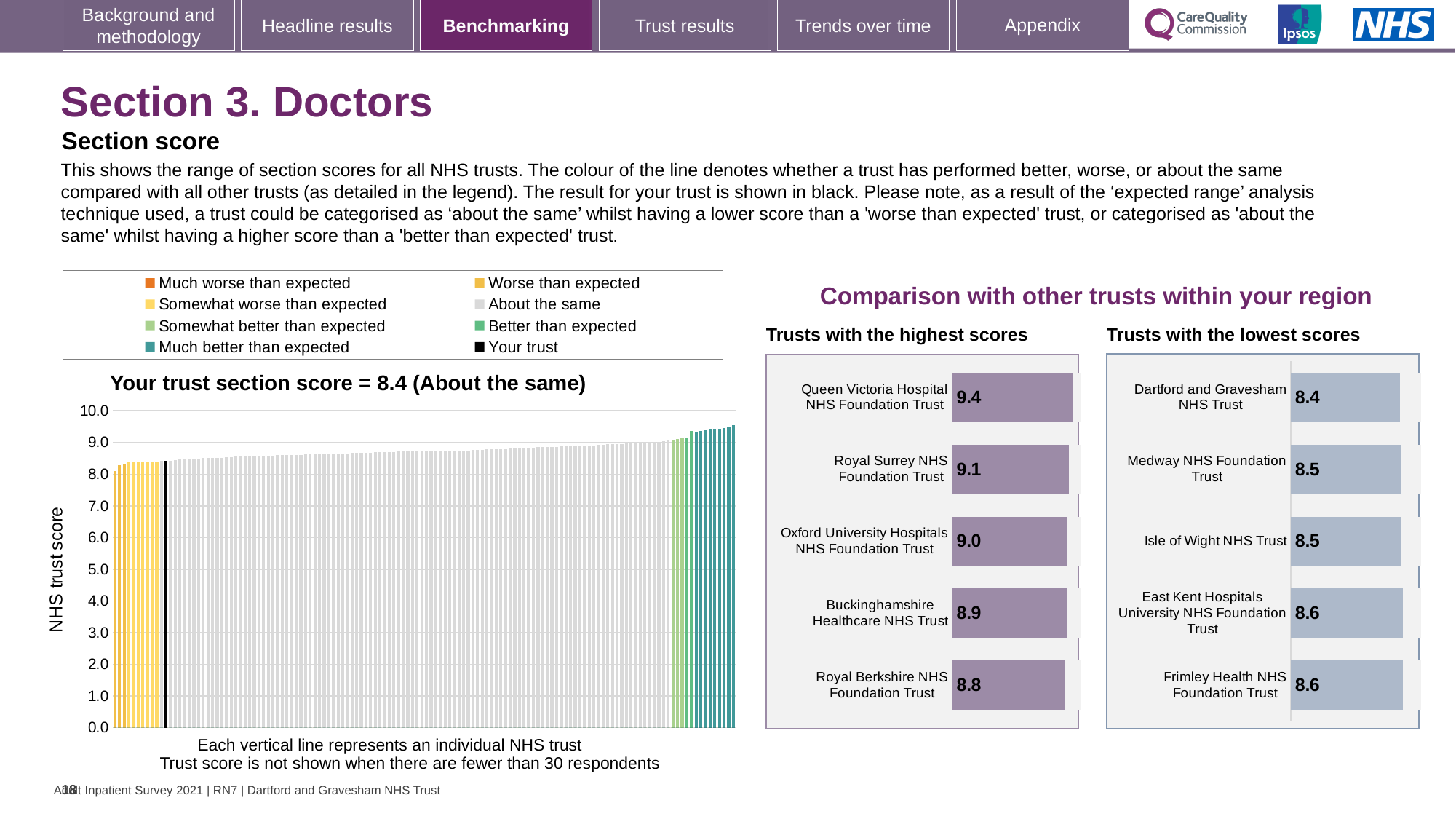
In the 'Trusts with the lowest scores' chart, what is the score for Medway NHS Foundation Trust? 8.5 In the 'Trusts with the highest scores' chart, what is the score for Buckinghamshire Healthcare NHS Trust? 8.9 In the 'Trusts with the highest scores' chart, what is the difference between the scores of Queen Victoria Hospital NHS Foundation Trust and Royal Berkshire NHS Foundation Trust? 0.6 According to the title of the main section score chart on the left, what is your trust's section score? 8.4 In the 'Trusts with the lowest scores' chart, which trust has the lowest score? Dartford and Gravesham NHS Trust How many trusts are shown in the 'Trusts with the lowest scores' chart? 5 In the 'Trusts with the highest scores' chart, which has the higher score: Royal Surrey NHS Foundation Trust or Oxford University Hospitals NHS Foundation Trust? Royal Surrey NHS Foundation Trust In the 'Trusts with the highest scores' chart, which trust has the highest score? Queen Victoria Hospital NHS Foundation Trust What kind of chart is the main section score chart on the left? Bar chart How many entries does the legend above the main section score chart list? 8 In the 'Trusts with the lowest scores' chart, what is the difference between the scores of Frimley Health NHS Foundation Trust and Dartford and Gravesham NHS Trust? 0.2 In the 'Trusts with the highest scores' chart, what is the score for Queen Victoria Hospital NHS Foundation Trust? 9.4